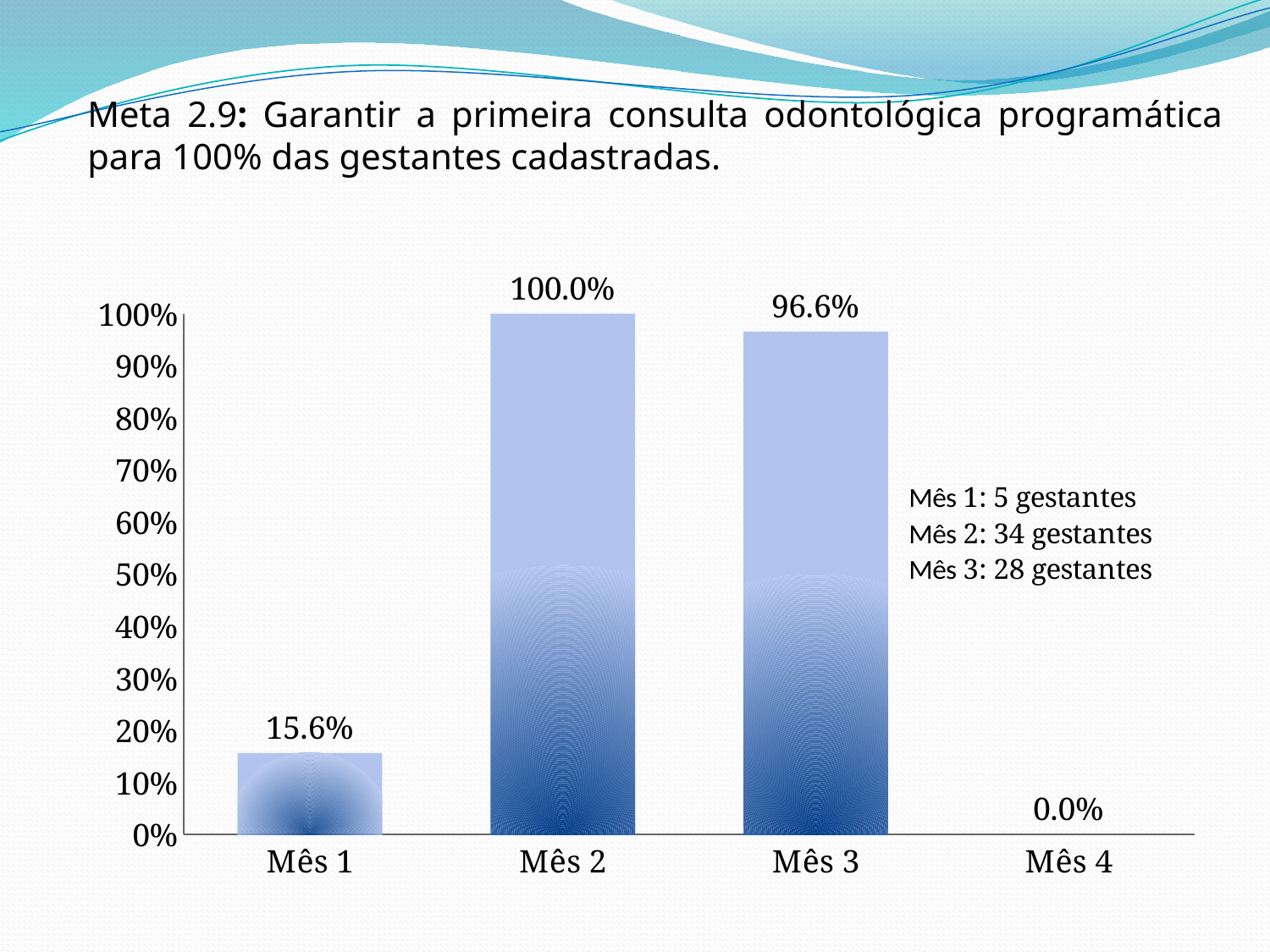
What is the value for Mês 4? 0.0% Which month has the highest value? Mês 2 What is the value for Mês 2? 100.0% What is the difference between the values for Mês 3 and Mês 1? 81.0% What is the difference between the values for Mês 2 and Mês 3? 3.4% Which month has the lowest value? Mês 4 Is the value for Mês 1 greater or less than 20%? less What is the value for Mês 1? 15.6% What kind of chart is shown on the slide? bar chart Which is larger, the value for Mês 1 or the value for Mês 3? Mês 3 What is the value for Mês 3? 96.6% How many months are shown on the x axis? 4